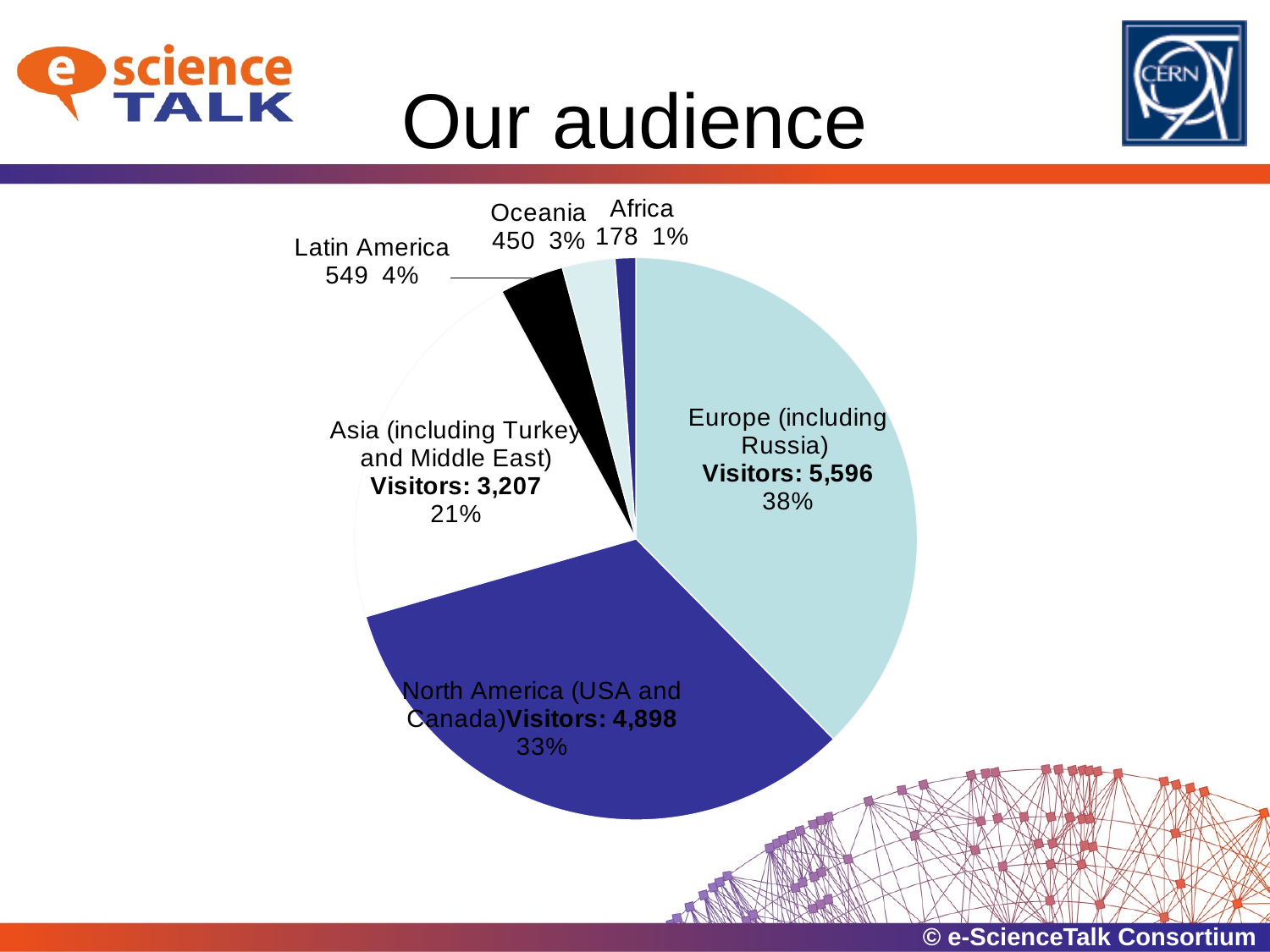
How many visitors are shown for North America (USA and Canada)? 4,898 What is the difference in visitors between Europe (including Russia) and North America (USA and Canada)? 698 What kind of chart is shown on the slide? pie chart How many visitors are shown for Europe (including Russia)? 5,596 How many visitors are shown for Asia (including Turkey and Middle East)? 3,207 What share of the pie does Africa represent? 1% How many visitors are shown for Oceania? 450 Which region has the largest slice of the pie? Europe (including Russia) Which has more visitors, Latin America or Oceania? Latin America What share of the pie does Latin America represent? 4% Which region has the smallest slice of the pie? Africa How many slices does the pie chart have? 6